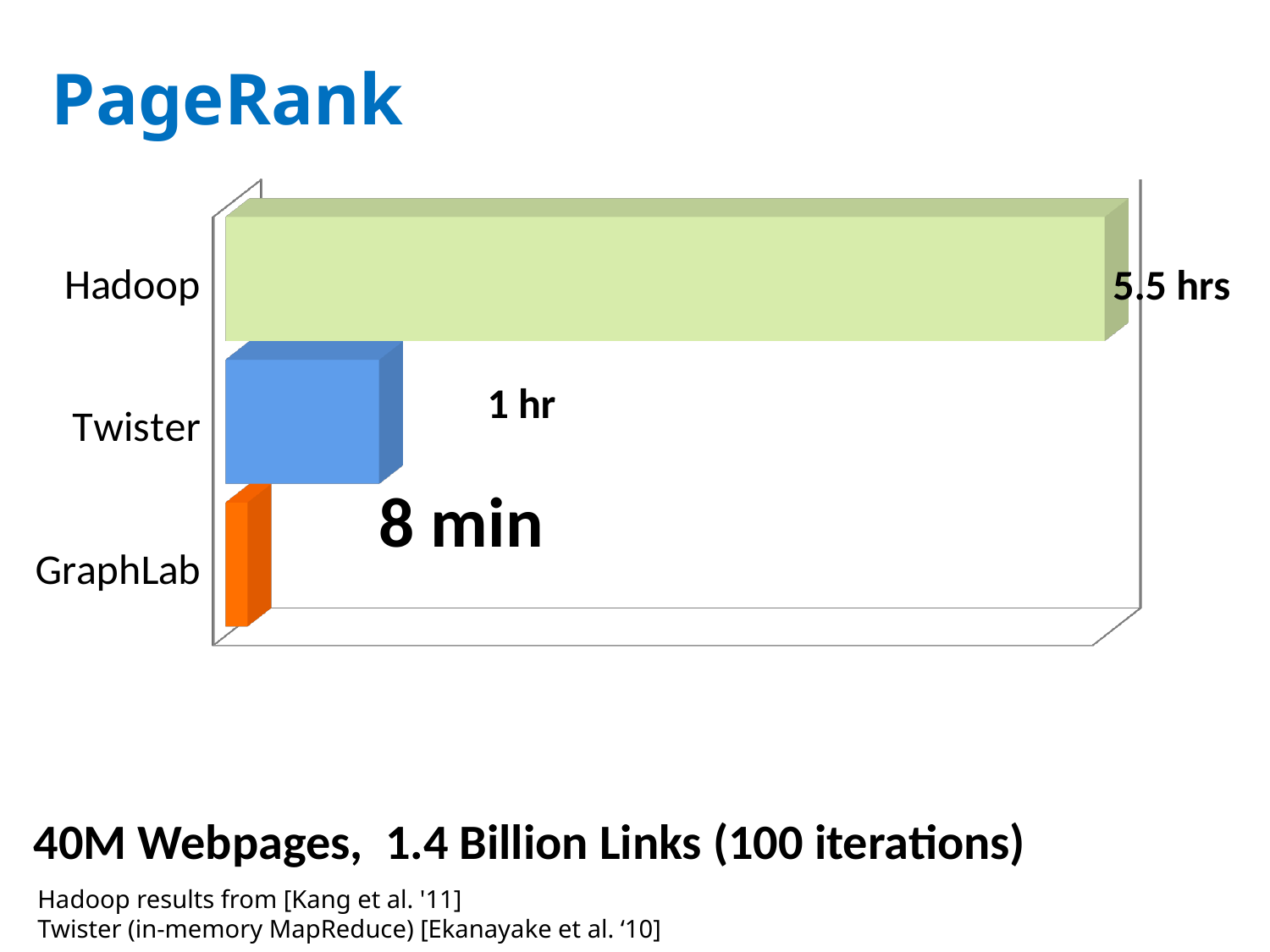
What colour is the bar for GraphLab? orange What kind of chart is shown on the slide? bar chart Which system has the shortest bar? GraphLab What is the value shown for Hadoop? 5.5 hrs How much longer does Hadoop take than Twister? 4.5 hrs Which system has the longest bar? Hadoop What is the value shown for GraphLab? 8 min What is the title of the slide? PageRank Which takes longer, Twister or GraphLab? Twister What is the value shown for Twister? 1 hr How many systems are compared in the chart? 3 Which takes longer, Hadoop or Twister? Hadoop